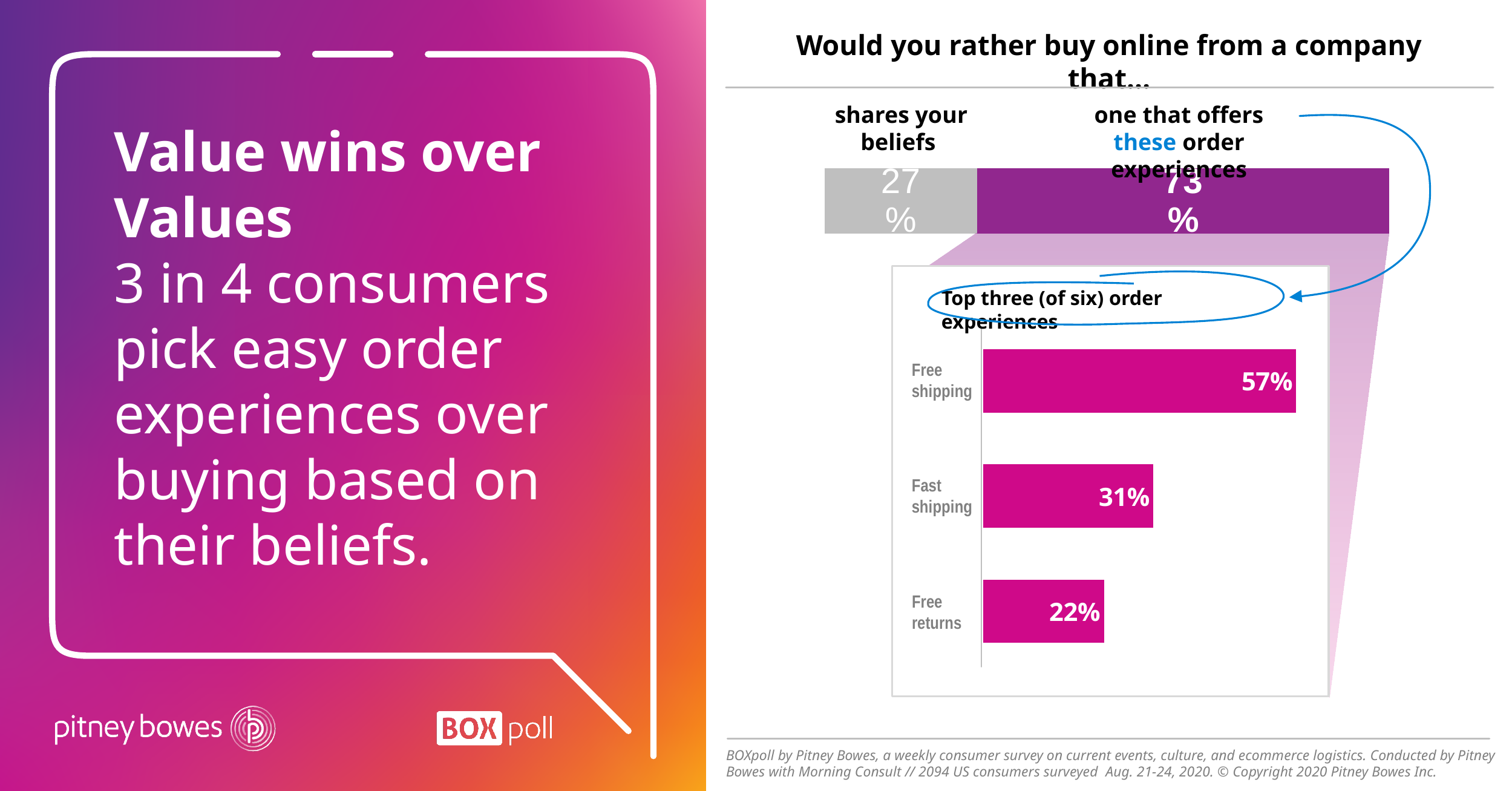
In the 'Top three (of six) order experiences' chart, what is the value for Fast shipping? 31% In the 'Would you rather buy online from a company that...' chart, what percentage chose a company that offers these order experiences? 73% What kind of chart is the 'Top three (of six) order experiences' chart? Bar chart In the 'Top three (of six) order experiences' chart, what is the value for Free returns? 22% In the 'Would you rather buy online from a company that...' chart, what is the difference between the two percentages? 46% In the 'Top three (of six) order experiences' chart, which order experience has the lowest value? Free returns In the 'Top three (of six) order experiences' chart, what is the difference between Free shipping and Fast shipping? 26% In the 'Top three (of six) order experiences' chart, what is the value for Free shipping? 57% In the 'Top three (of six) order experiences' chart, which order experience has the highest value? Free shipping In the 'Would you rather buy online from a company that...' chart, what percentage chose a company that shares your beliefs? 27% In the 'Top three (of six) order experiences' chart, how many order experiences are plotted? 3 In the 'Would you rather buy online from a company that...' chart, which option received the larger share? one that offers these order experiences